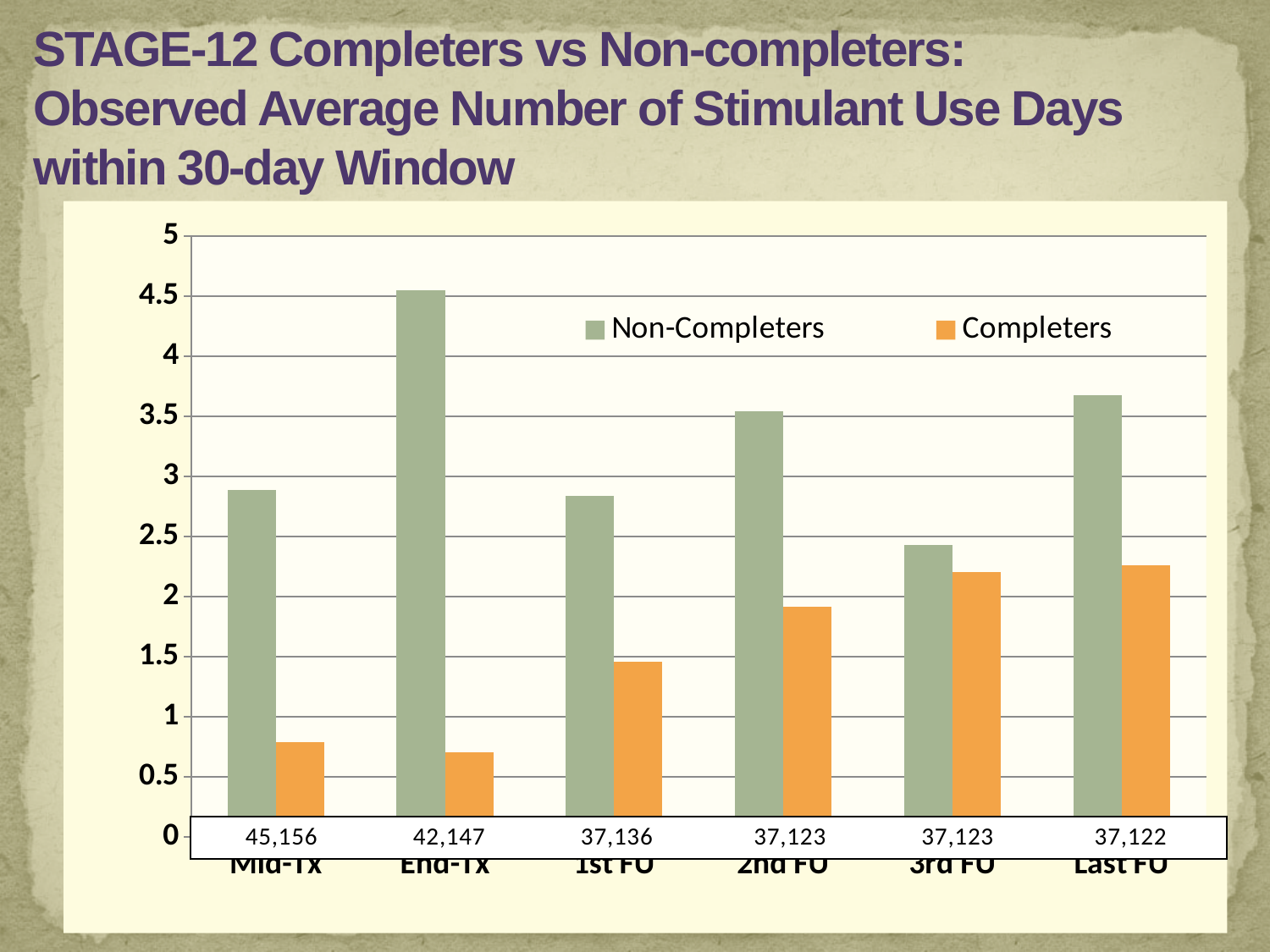
Is the Completers value at 2nd FO greater or less than 2? less At which time point is the Non-Completers value lowest? 3rd FU Is the Non-Completers value at End-Tx greater or less than 4? greater How many series does the legend list? 2 Is the Non-Completers value at 2nd FO greater or less than 3? greater How many time-point categories are shown on the x axis? 6 Do the Completers values rise or fall from End-Tx through Last FO? rise Which colour represents the Completers series in the legend? orange At which time point is the Non-Completers value highest? End-Tx At Mid-Tx, which group has the larger value, Non-Completers or Completers? Non-Completers What kind of chart is shown on the slide? bar chart